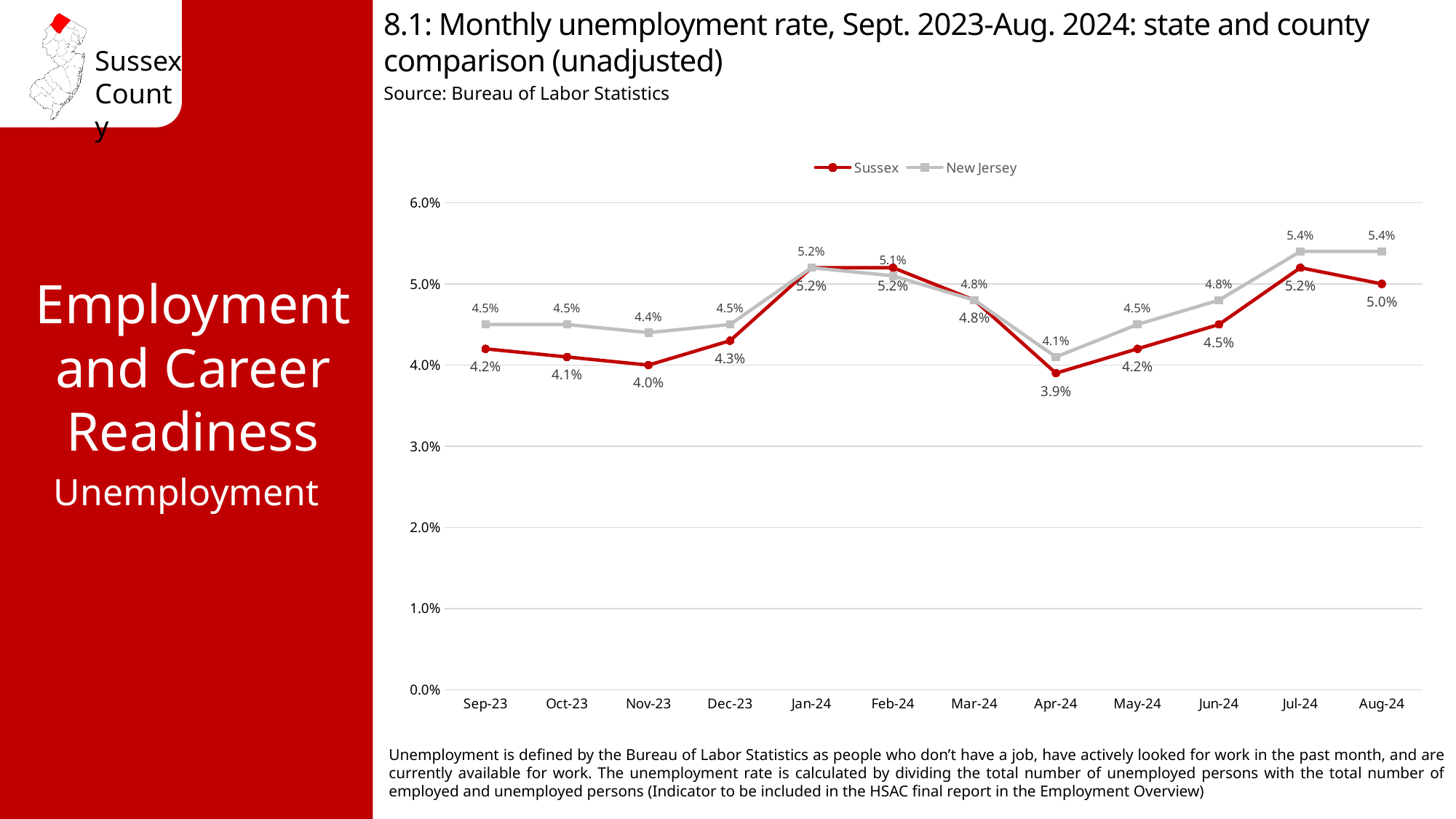
What was the Sussex unemployment rate in Apr-24? 3.9% What is the difference between the New Jersey and Sussex unemployment rates in Aug-24? 0.4% In which month was the Sussex unemployment rate lowest? Apr-24 What is the source cited for the chart? Bureau of Labor Statistics What kind of chart is shown on the slide? Line chart How many months are plotted on the x axis? 12 Did the Sussex unemployment rate rise or fall from Apr-24 to Jul-24? Rise What was the Sussex unemployment rate in Aug-24? 5.0% Which had the higher unemployment rate in Feb-24, Sussex or New Jersey? Sussex How many series does the legend list? 2 What was the New Jersey unemployment rate in Nov-23? 4.4% What was the highest New Jersey unemployment rate shown on the chart? 5.4%